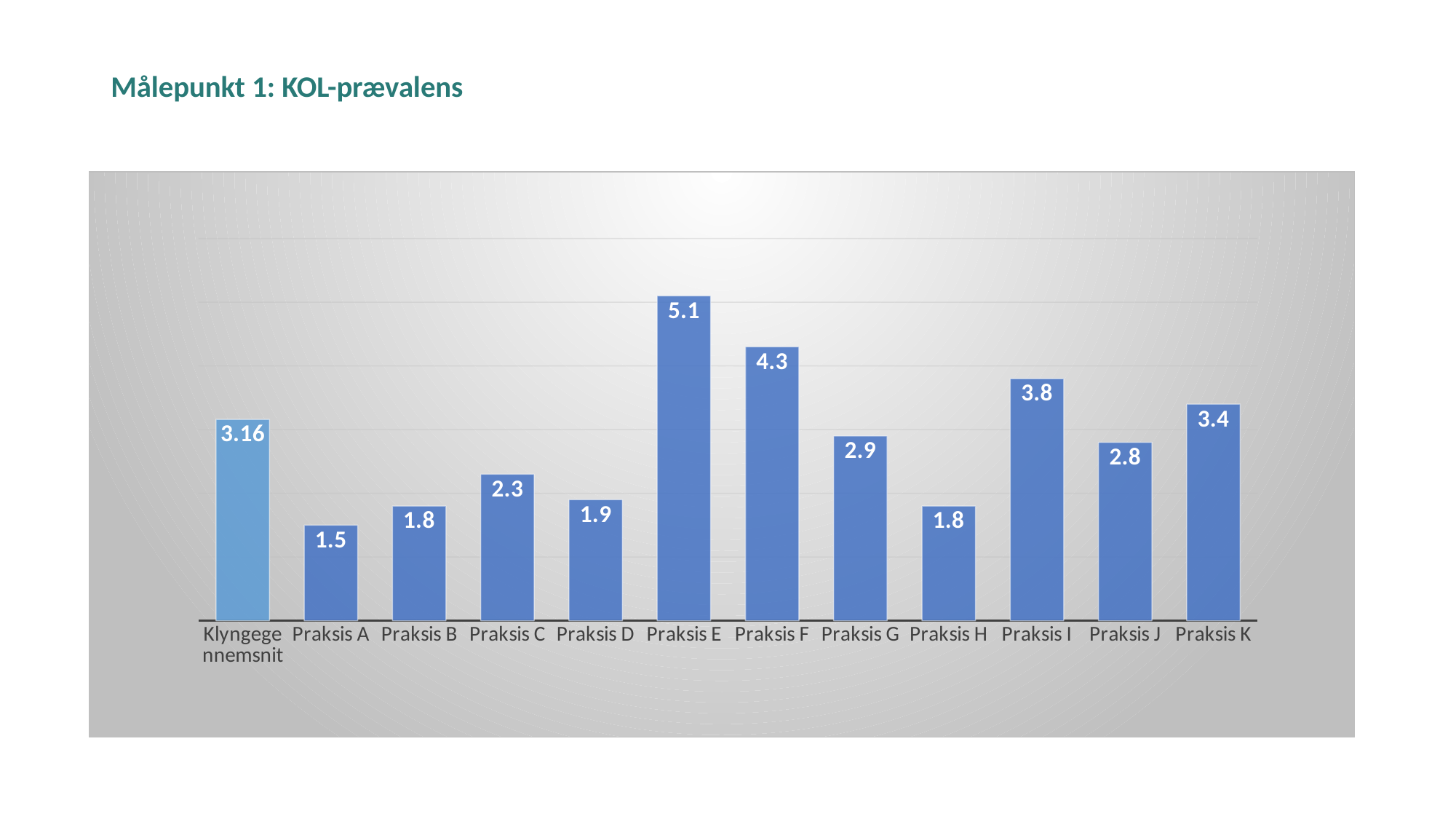
Which category has the lowest value? Praksis A What is the value for Praksis E? 5.1 What is the value for Praksis J? 2.8 Which is larger, the value for Praksis I or the value for Praksis G? Praksis I What kind of chart is shown on the slide? Bar chart What is the title of the slide? Målepunkt 1: KOL-prævalens What is the value for Klyngegennemsnit? 3.16 How many categories are shown on the x axis? 12 Which category has the highest value? Praksis E What is the difference between the values for Praksis K and Praksis A? 1.9 Which is larger, the value for Praksis C or the value for Praksis D? Praksis C What is the difference between the values for Praksis E and Praksis F? 0.8